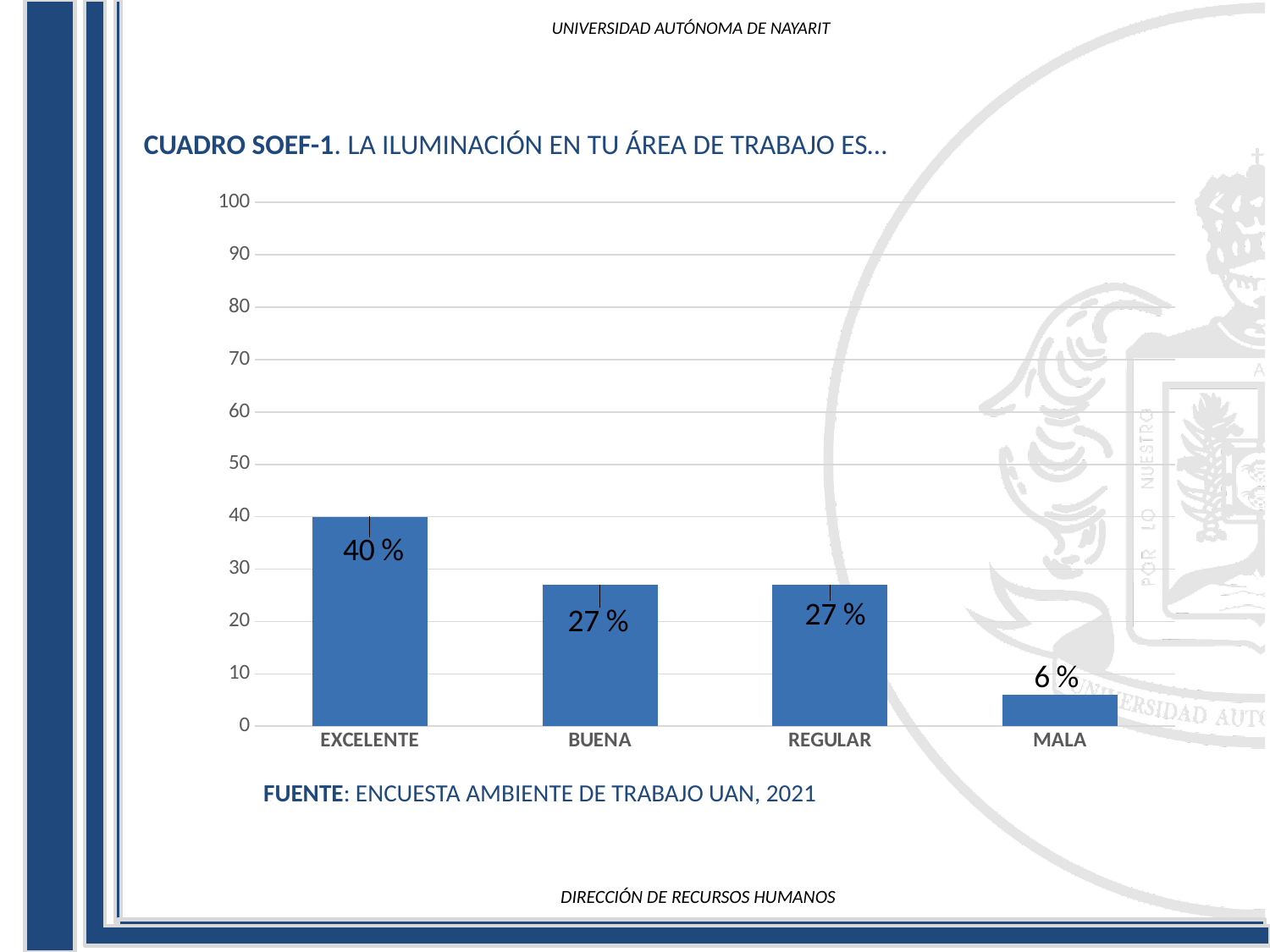
What is the value for EXCELENTE? 40 % What is the difference between the values for EXCELENTE and REGULAR? 13 % How many categories are shown on the x axis? 4 What is the value for BUENA? 27 % What is the value for MALA? 6 % What kind of chart is shown on the slide? bar chart Which category has the lowest value? MALA Is the value for EXCELENTE greater or less than 30? greater What is the source cited below the chart? ENCUESTA AMBIENTE DE TRABAJO UAN, 2021 Which is larger, the value for BUENA or the value for MALA? BUENA What is the difference between the values for EXCELENTE and MALA? 34 % Which category has the highest value? EXCELENTE